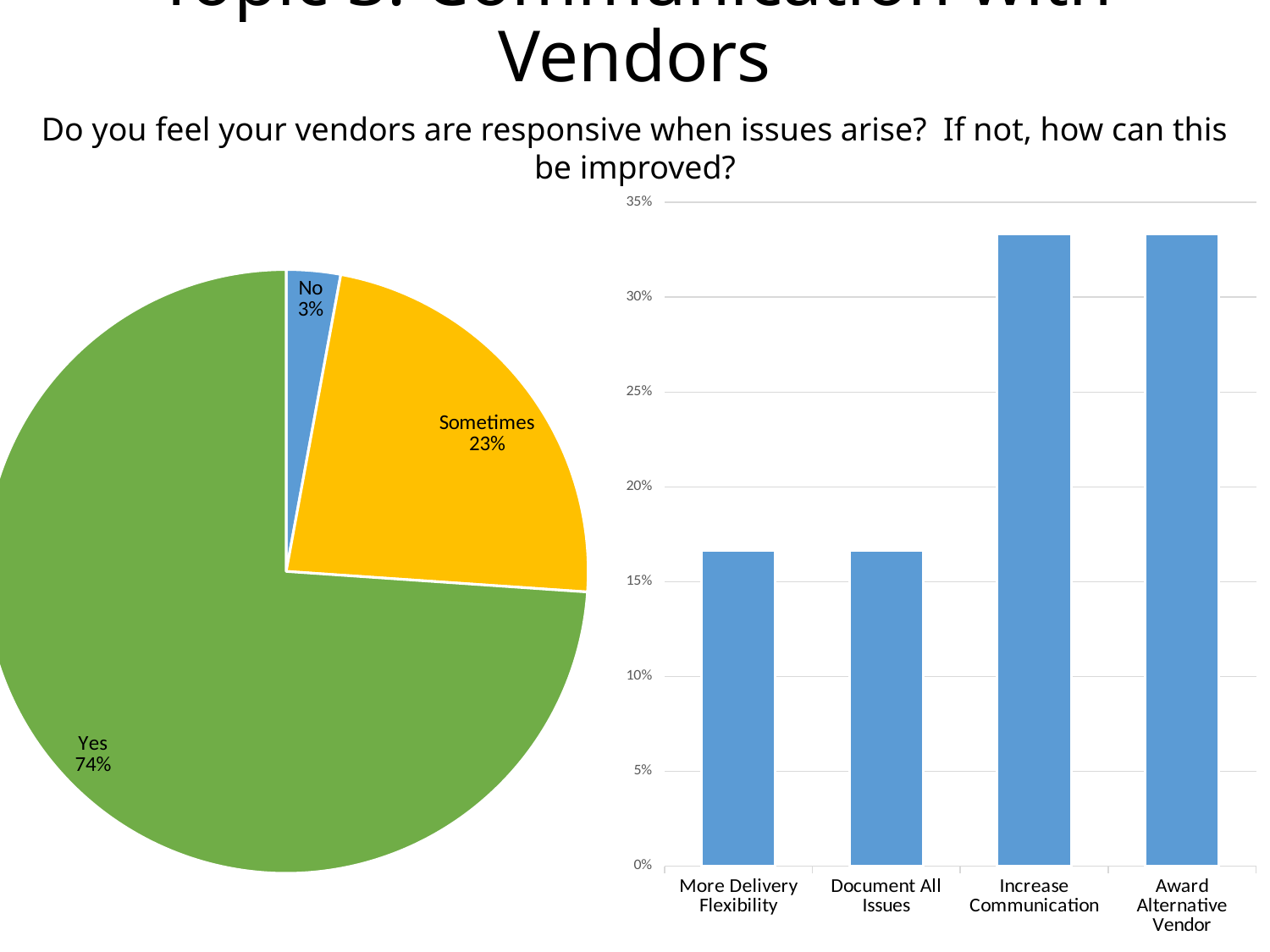
In the pie chart on the left, which response has the smallest slice? No In the bar chart on the right, is the value for Document All Issues greater or less than 20%? less In the bar chart on the right, which is larger: the value for Award Alternative Vendor or the value for More Delivery Flexibility? Award Alternative Vendor In the pie chart on the left, which response has the largest slice? Yes In the pie chart on the left, what percentage of respondents answered Yes? 74% What kind of chart is on the right side of the slide? Bar chart How many categories are shown in the bar chart on the right? 4 In the pie chart on the left, what percentage of respondents answered No? 3% In the pie chart on the left, what is the difference in percentage points between the Yes and Sometimes slices? 51 In the bar chart on the right, is the value for Increase Communication greater or less than 30%? greater How many slices does the pie chart on the left have? 3 In the pie chart on the left, what percentage of respondents answered Sometimes? 23%